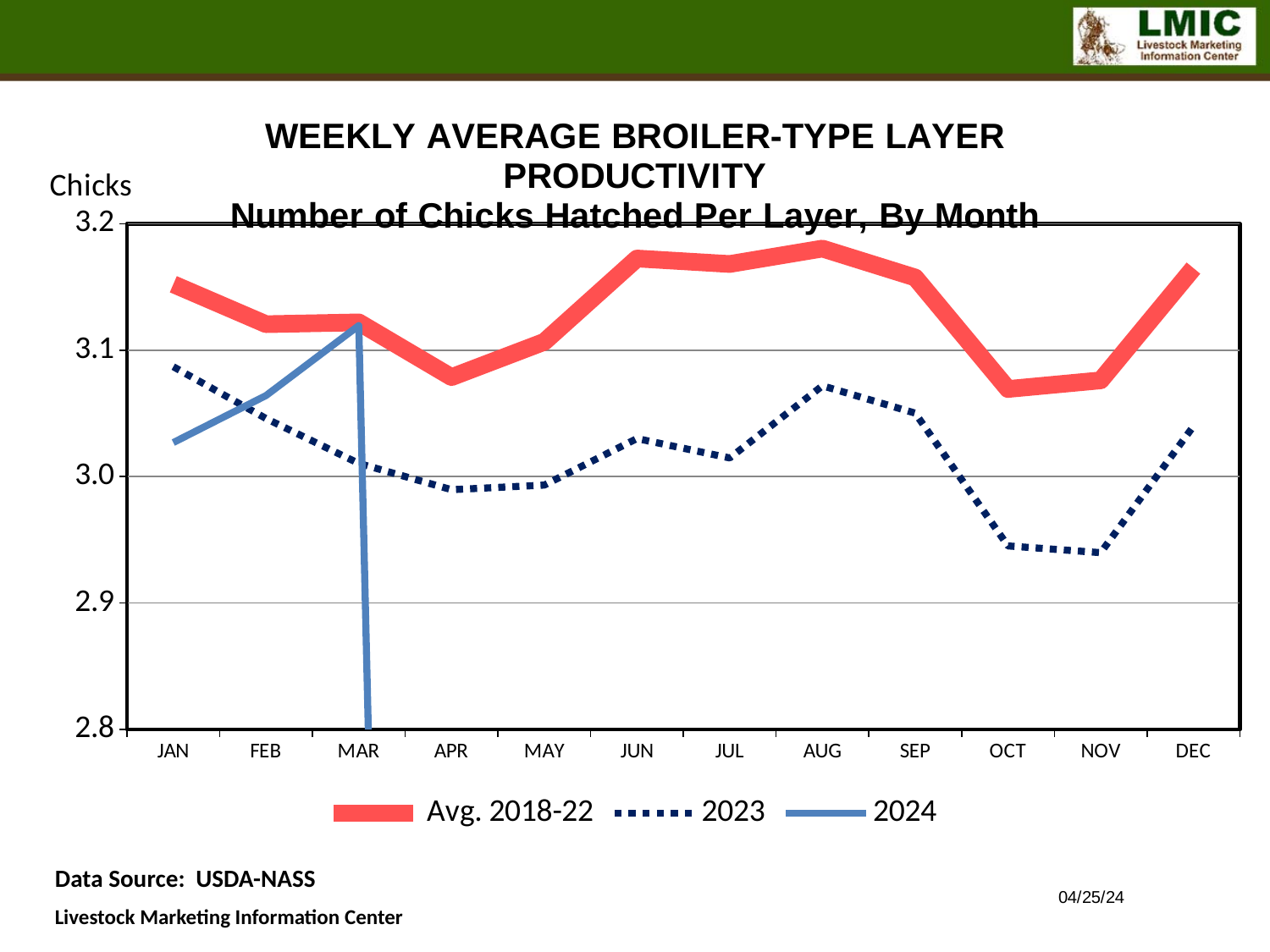
Is the 2023 value for OCT greater or less than 3.0? less How many series does the legend list? 3 Is the 2024 value for JAN greater or less than 3.0? greater Is the 2023 value for AUG greater or less than 3.0? greater In JAN, which series has the higher value: Avg. 2018-22 or 2023? Avg. 2018-22 Does the 2023 series rise or fall from AUG to NOV? fall In MAR, which series has the higher value: 2024 or 2023? 2024 What label is shown on the vertical axis of the chart? Chicks What kind of chart is shown on the slide? line chart How many months are shown along the x axis? 12